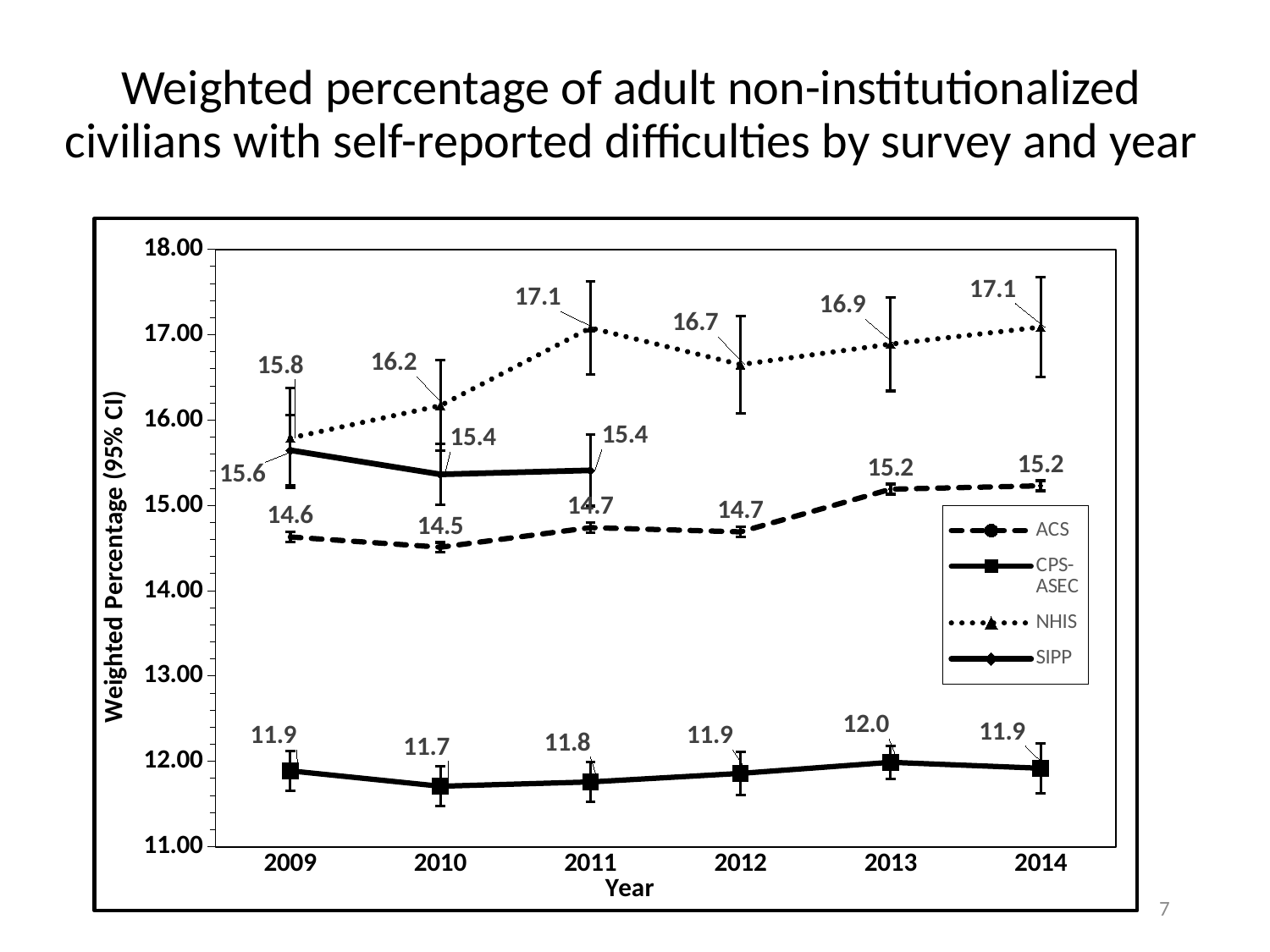
How many years are shown on the x axis? 6 How many series does the legend list? 4 What kind of chart is shown on the slide? Line chart In which year is the NHIS value lowest? 2009 What is the difference between the NHIS and CPS-ASEC values in 2014? 5.2 What is the CPS-ASEC value for 2013? 12.0 What is the SIPP value for 2009? 15.6 What is the label on the y axis? Weighted Percentage (95% CI) What is the NHIS value for 2011? 17.1 Which is larger: the ACS value in 2013 or the SIPP value in 2011? SIPP value in 2011 What is the ACS value for 2014? 15.2 In which year is the CPS-ASEC value highest? 2013